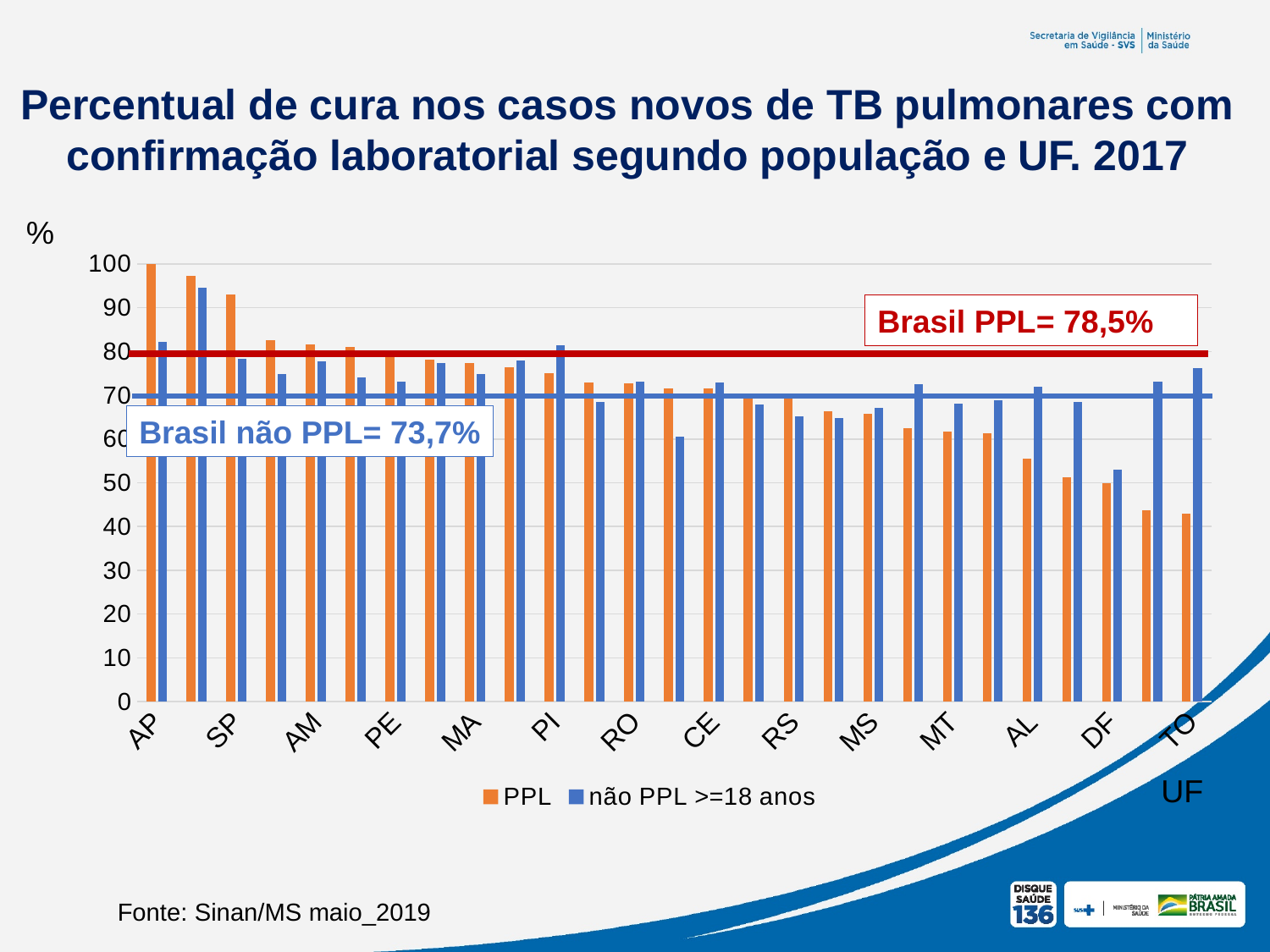
Do the PPL values generally rise or fall from left to right along the x axis? fall Is the PPL value for AL greater or less than 60? less Is the não PPL >=18 anos value for TO greater or less than 70? greater How many series does the legend list? 2 Is the PPL value for SP greater or less than 90? greater Which UF has the highest PPL value? AP What kind of chart is shown on the slide? bar chart What value is given for Brasil não PPL in the text box on the chart? 73,7% For AL, which is larger: the PPL value or the não PPL >=18 anos value? não PPL >=18 anos What are the two series named in the legend? PPL and não PPL >=18 anos What value is given for Brasil PPL in the text box on the chart? 78,5%